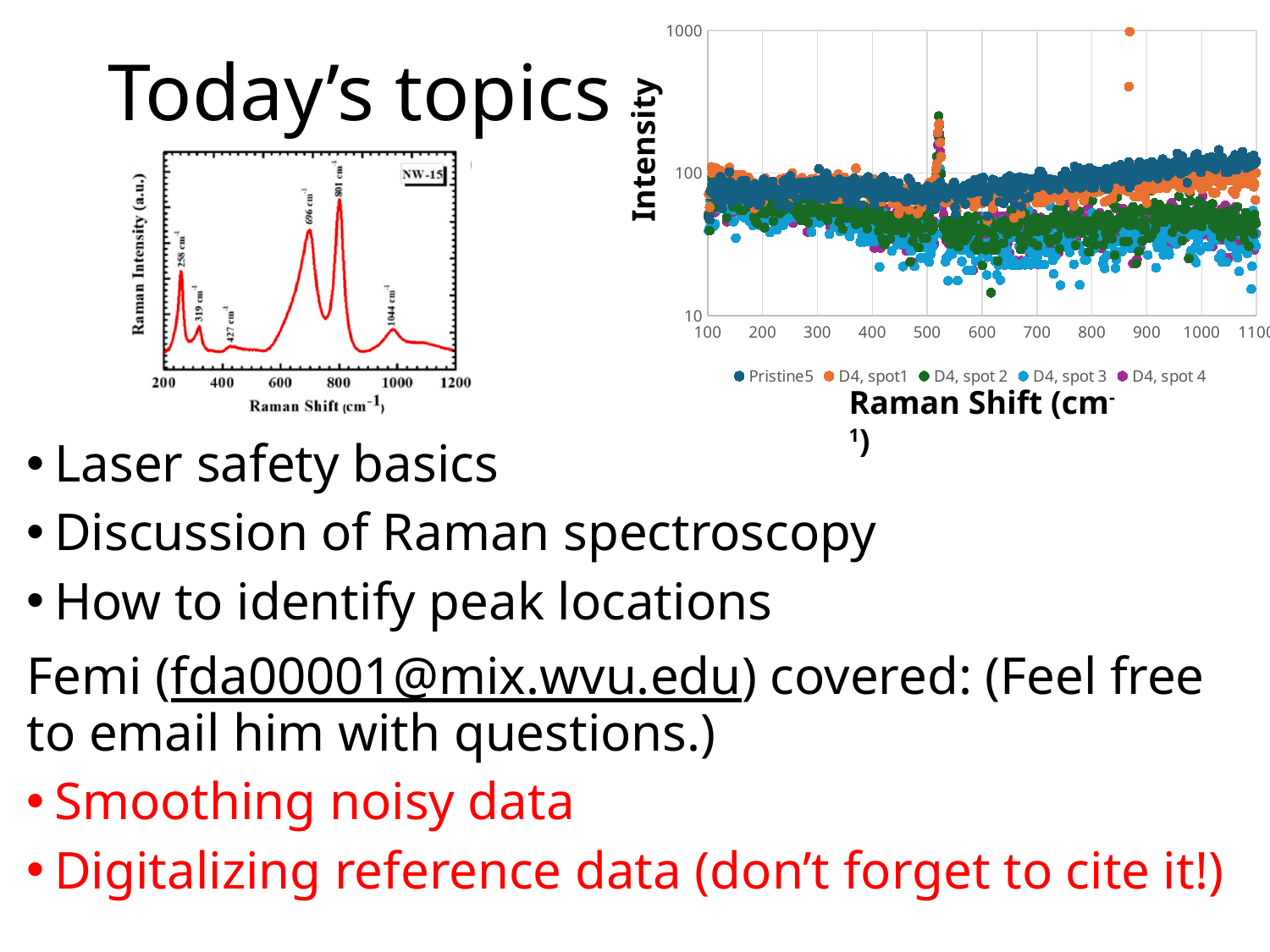
What kind of chart is the left-hand Raman spectrum? line chart In the right-hand chart, which series is plotted in orange? D4, spot1 How many peaks are labeled with a wavenumber in the left-hand Raman spectrum? 6 In the left-hand Raman spectrum, which peak is taller: the one at 696 cm-1 or the one at 258 cm-1? 696 cm-1 In the left-hand Raman spectrum, which labeled peak has the lowest intensity? 427 cm-1 How many series does the legend of the right-hand scatter chart list? 5 In the left-hand Raman spectrum, which labeled peak has the highest intensity? 801 cm-1 In the right-hand chart, which series contains the highest plotted point? D4, spot1 In the right-hand chart, is the D4, spot 3 series at a Raman shift of 1000 greater or less than 100? less In the right-hand chart, is the Pristine5 series at a Raman shift of 1000 greater or less than 100? greater What kind of chart is the right-hand chart with the Intensity axis? scatter chart What is the label on the vertical axis of the right-hand chart? Intensity